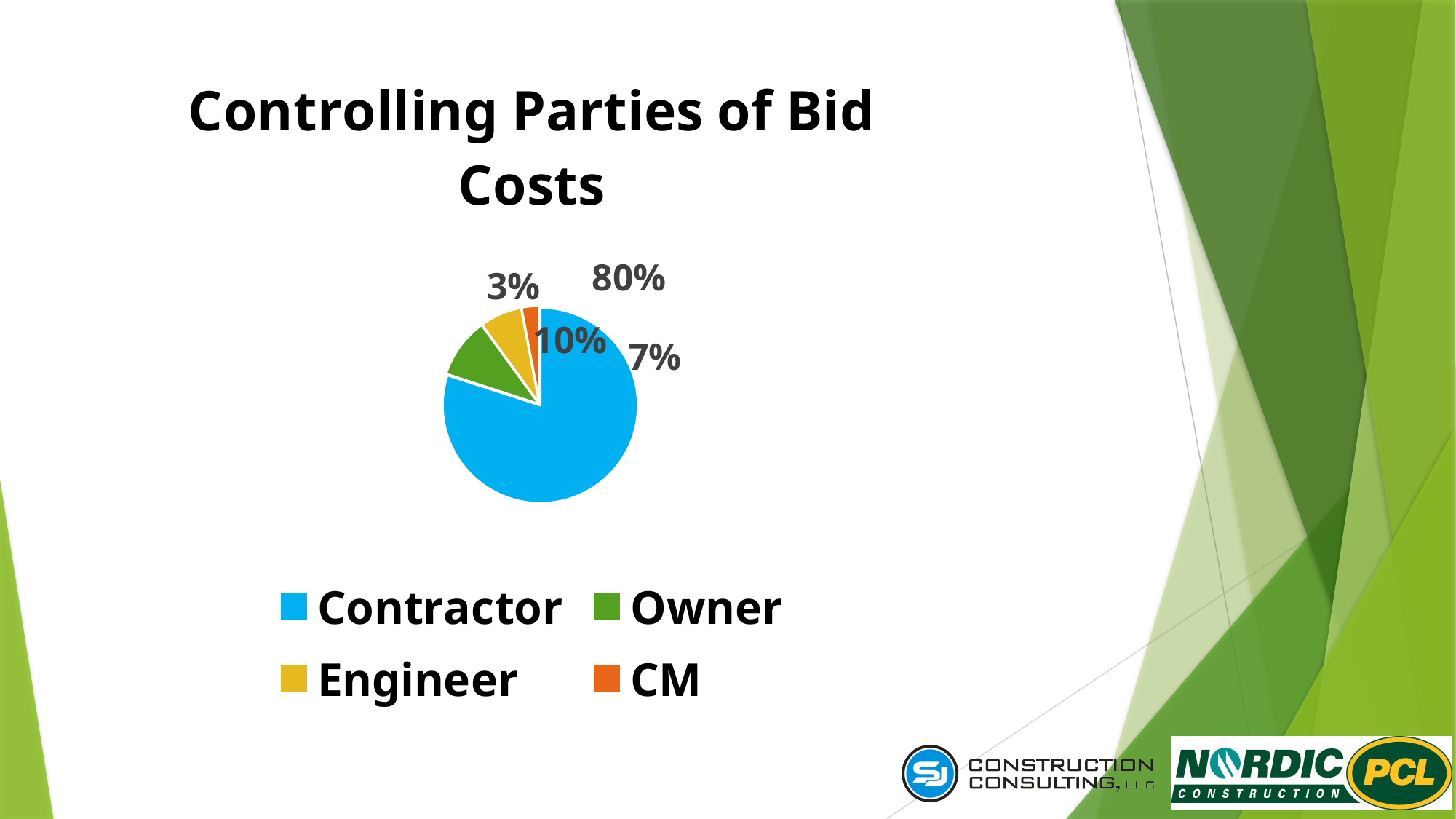
Which is larger, the Owner's share or the Engineer's share? Owner How many categories does the legend list? 4 What share of bid costs is controlled by the Owner? 10% What is the title of the chart? Controlling Parties of Bid Costs Which party controls the largest share of bid costs? Contractor Which party controls the smallest share of bid costs? CM Which colour represents the Contractor in the pie chart? blue What share of bid costs is controlled by the Engineer? 7% What is the difference between the Contractor's share and the Owner's share? 70% What type of chart is shown on the slide? pie chart What share of bid costs is controlled by CM? 3% What share of bid costs is controlled by the Contractor? 80%